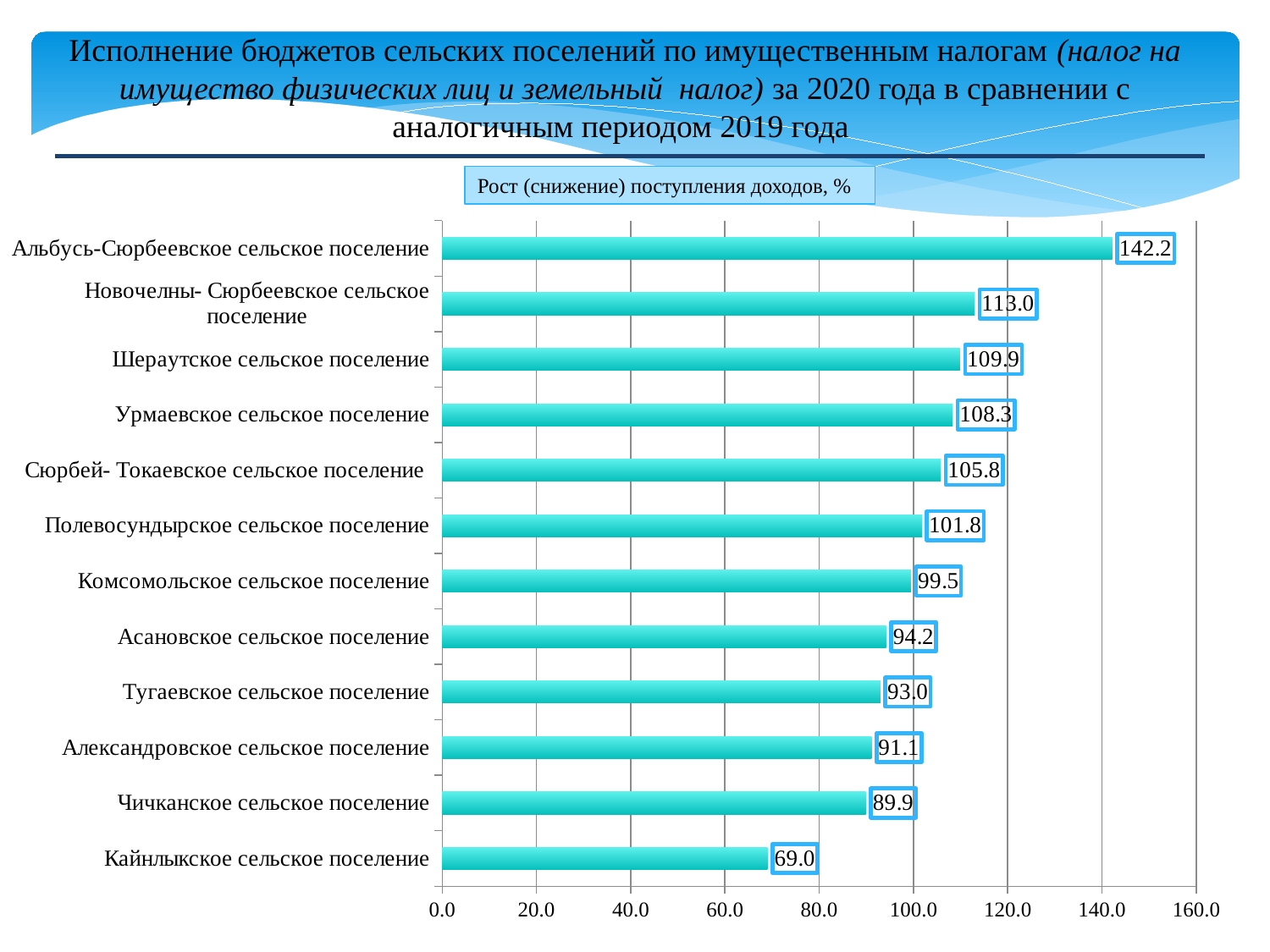
What is the value for Кайнлыкское сельское поселение? 69.0 Which is larger, the value for Тугаевское сельское поселение or Асановское сельское поселение? Асановское сельское поселение Which settlement has the lowest value? Кайнлыкское сельское поселение Is the value for Чичканское сельское поселение greater or less than 100.0? less What is the value for Полевосундырское сельское поселение? 101.8 What is the title of the chart? Рост (снижение) поступления доходов, % What is the difference between the values for Шераутское сельское поселение and Урмаевское сельское поселение? 1.6 How many settlements are shown in the chart? 12 What is the difference between the values for Альбусь-Сюрбеевское сельское поселение and Кайнлыкское сельское поселение? 73.2 Which settlement has the highest value? Альбусь-Сюрбеевское сельское поселение What is the value for Альбусь-Сюрбеевское сельское поселение? 142.2 What kind of chart is shown on the slide? bar chart